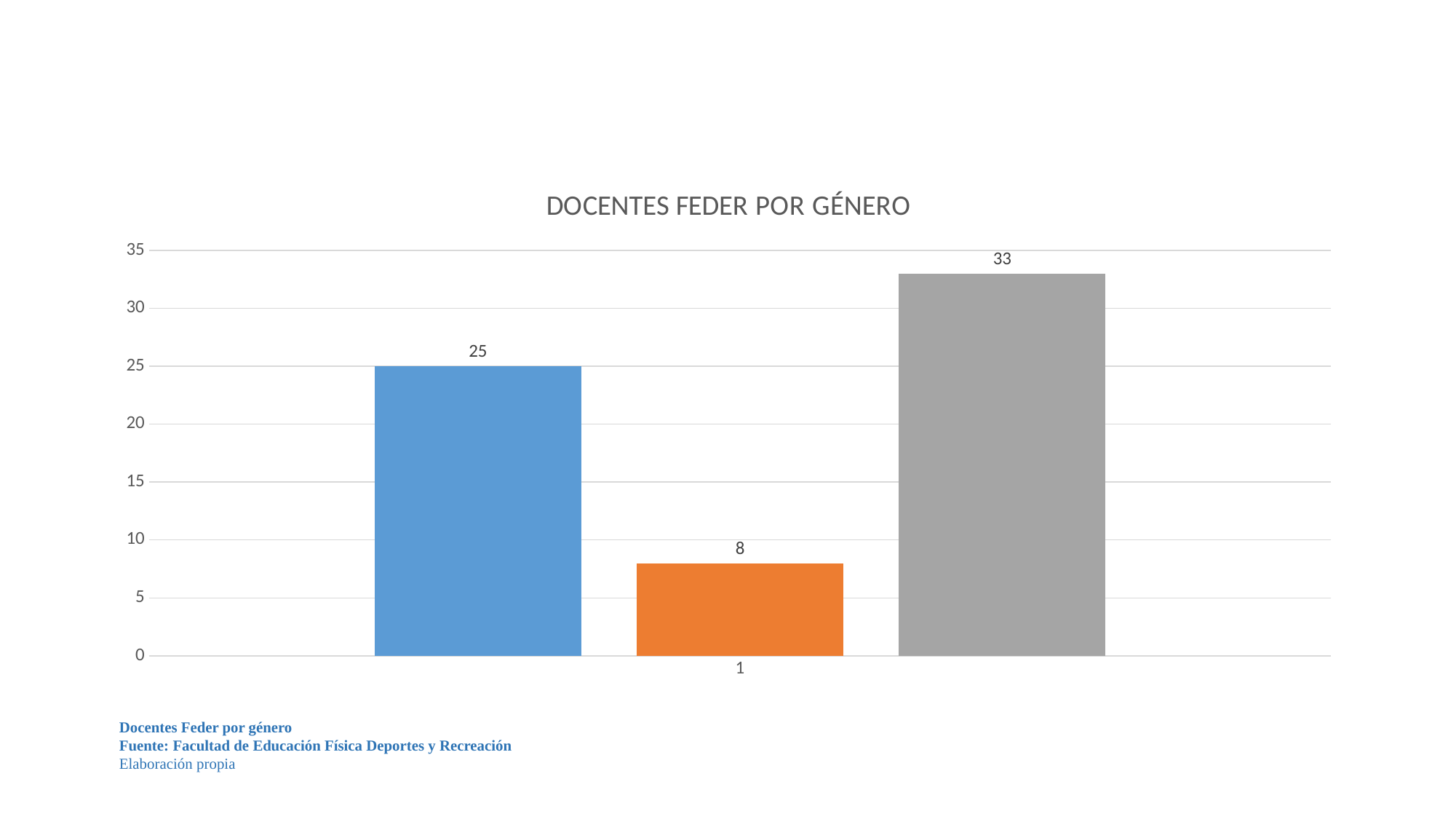
What type of chart is shown on the slide? bar chart Is the value of the gray bar greater or less than 30? greater What is the value of the orange bar (the middle bar)? 8 What is the value of the blue bar (the first bar from the left)? 25 What is the difference between the gray bar and the blue bar? 8 What is the value of the gray bar (the rightmost bar)? 33 What is the difference between the blue bar and the orange bar? 17 Which bar has the lowest value? the orange bar (8) Which is larger, the blue bar or the orange bar? the blue bar What is the title of the chart? DOCENTES FEDER POR GÉNERO Which bar has the highest value? the gray bar (33) How many bars are plotted in the chart? 3